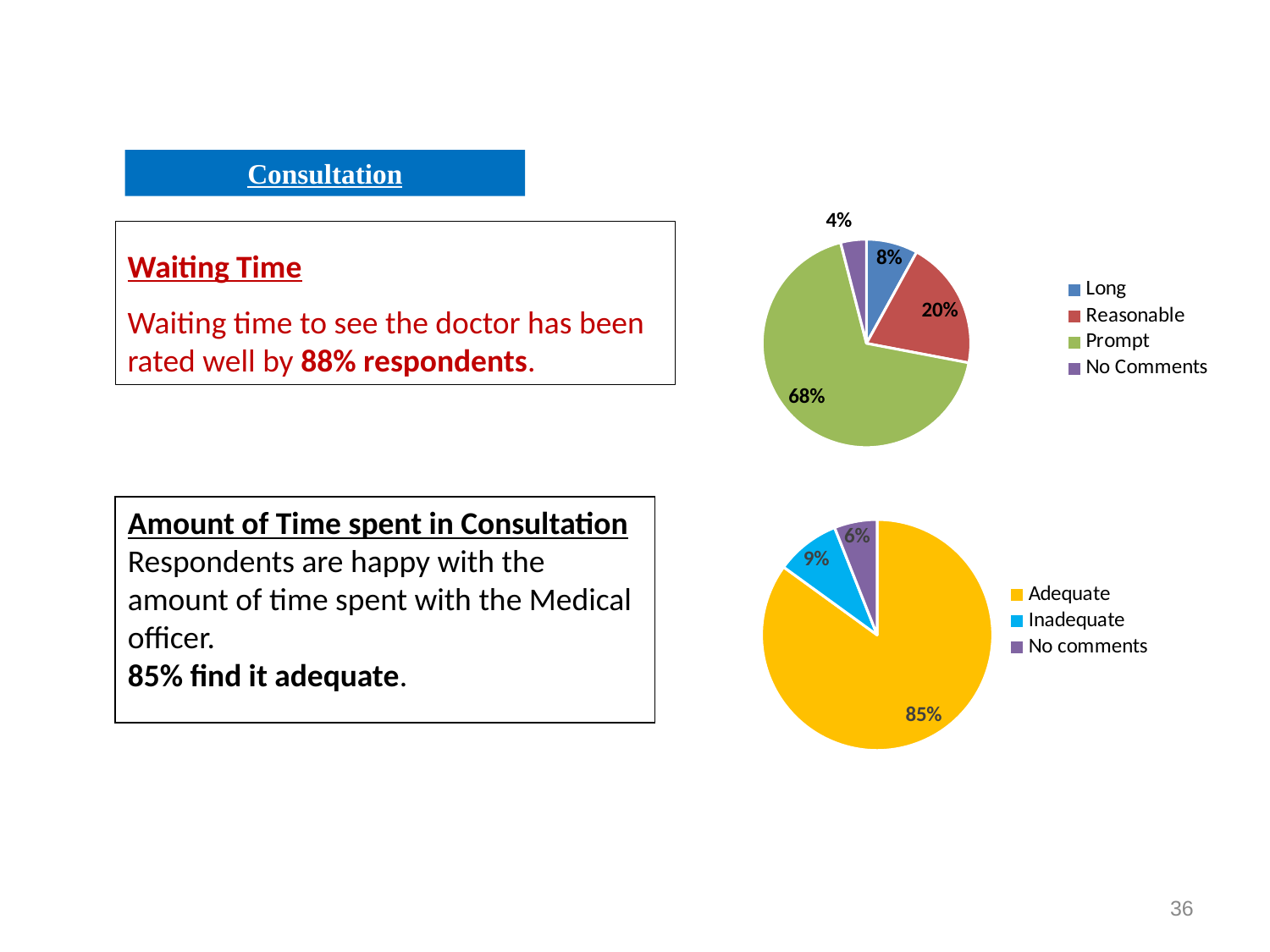
What type of chart is the bottom chart on the slide? Pie chart In the top pie chart, which category has the largest slice? Prompt In the top pie chart, how many categories does the legend list? 4 In the top pie chart, what share is labelled for the Reasonable slice? 20% In the top pie chart, what share is labelled for the Long slice? 8% In the top pie chart, which category has the smallest slice? No Comments In the bottom pie chart, what share is labelled for the Adequate slice? 85% In the bottom pie chart, how many categories does the legend list? 3 In the bottom pie chart, which is larger, Inadequate or No comments? Inadequate In the top pie chart, what is the difference between the Prompt and Reasonable shares? 48% In the top pie chart, what share is labelled for the Prompt slice? 68% In the bottom pie chart, what share is labelled for the Inadequate slice? 9%